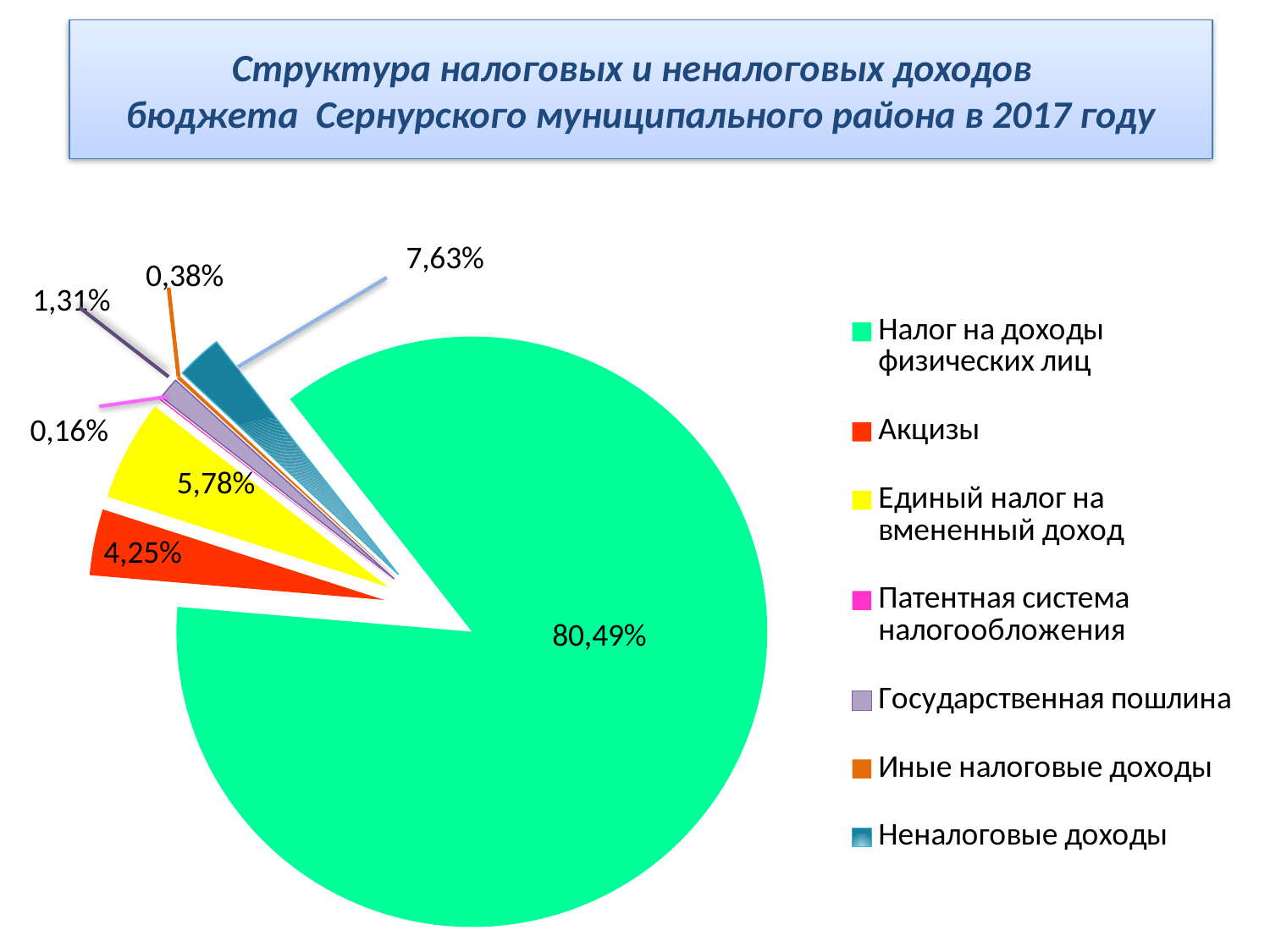
Which category has the largest slice of the pie? Налог на доходы физических лиц What share of the pie does "Налог на доходы физических лиц" have? 80,49% How many categories does the legend list? 7 What colour is the slice for "Иные налоговые доходы"? orange What is the difference between the shares of "Неналоговые доходы" and "Акцизы"? 3,38% What is the value shown for "Акцизы"? 4,25% What is the value shown for "Единый налог на вмененный доход"? 5,78% What is the value shown for "Государственная пошлина"? 1,31% What type of chart is shown on the slide? pie chart Which is larger: "Акцизы" or "Единый налог на вмененный доход"? Единый налог на вмененный доход What is the value shown for "Неналоговые доходы"? 7,63% Which category has the smallest slice of the pie? Патентная система налогообложения